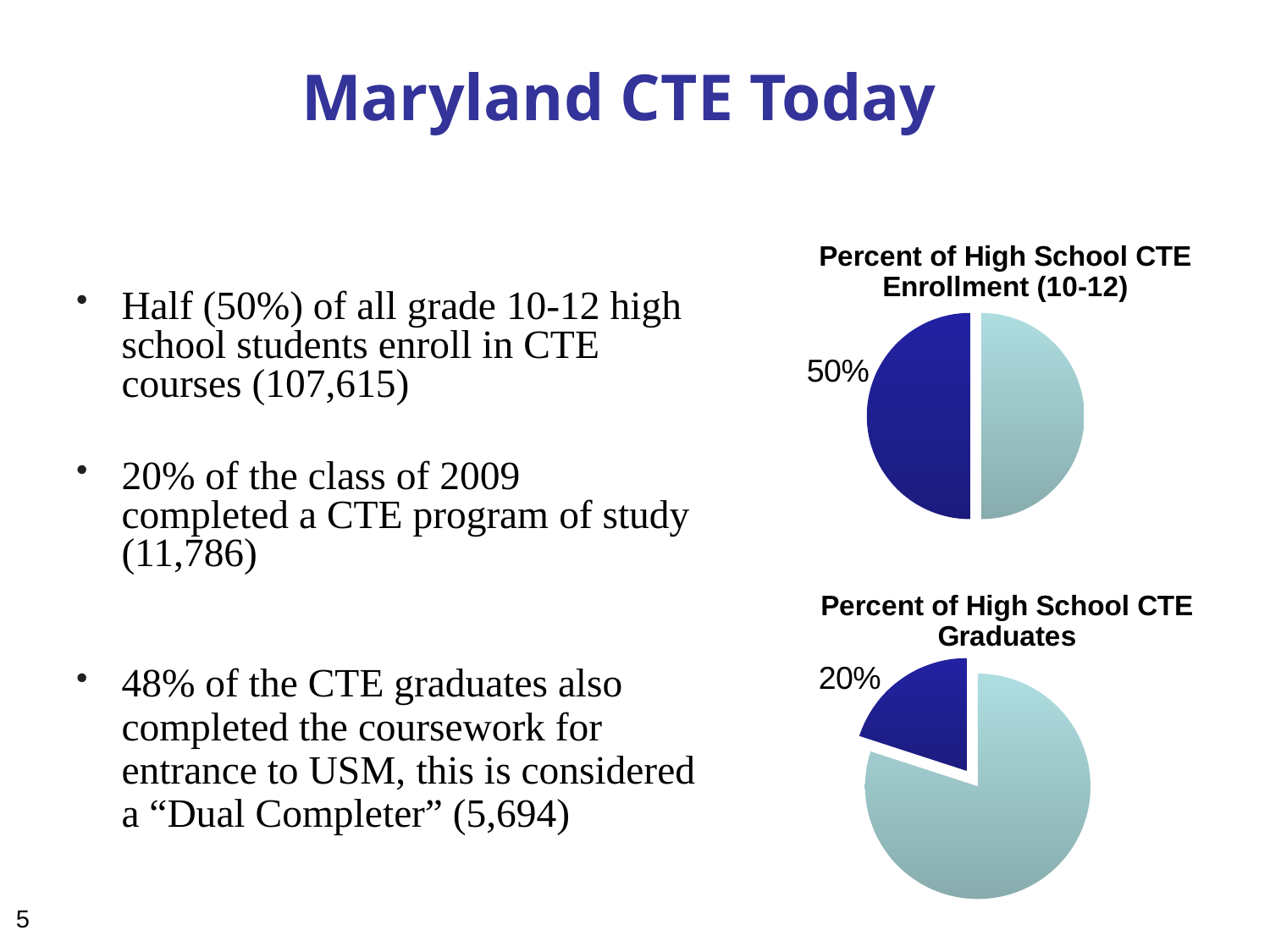
What kind of chart is the "Percent of High School CTE Enrollment (10-12)" chart? pie chart What is the title of the top pie chart on the slide? Percent of High School CTE Enrollment (10-12) In the "Percent of High School CTE Graduates" chart, what share of the pie does the dark blue slice represent? 20% In the "Percent of High School CTE Enrollment (10-12)" chart, what value is labeled on the dark blue slice? 50% What kind of chart is the "Percent of High School CTE Graduates" chart? pie chart What is the difference between the labeled dark blue slice in the "Percent of High School CTE Enrollment (10-12)" chart and the labeled dark blue slice in the "Percent of High School CTE Graduates" chart? 30% How many slices does the "Percent of High School CTE Enrollment (10-12)" pie chart have? 2 How many slices does the "Percent of High School CTE Graduates" pie chart have? 2 In the "Percent of High School CTE Graduates" chart, what value is labeled on the dark blue slice? 20% In the "Percent of High School CTE Graduates" chart, which slice is larger, the dark blue slice or the light teal slice? the light teal slice What is the title of the bottom pie chart on the slide? Percent of High School CTE Graduates Which chart has the larger labeled dark blue slice, "Percent of High School CTE Enrollment (10-12)" or "Percent of High School CTE Graduates"? Percent of High School CTE Enrollment (10-12)